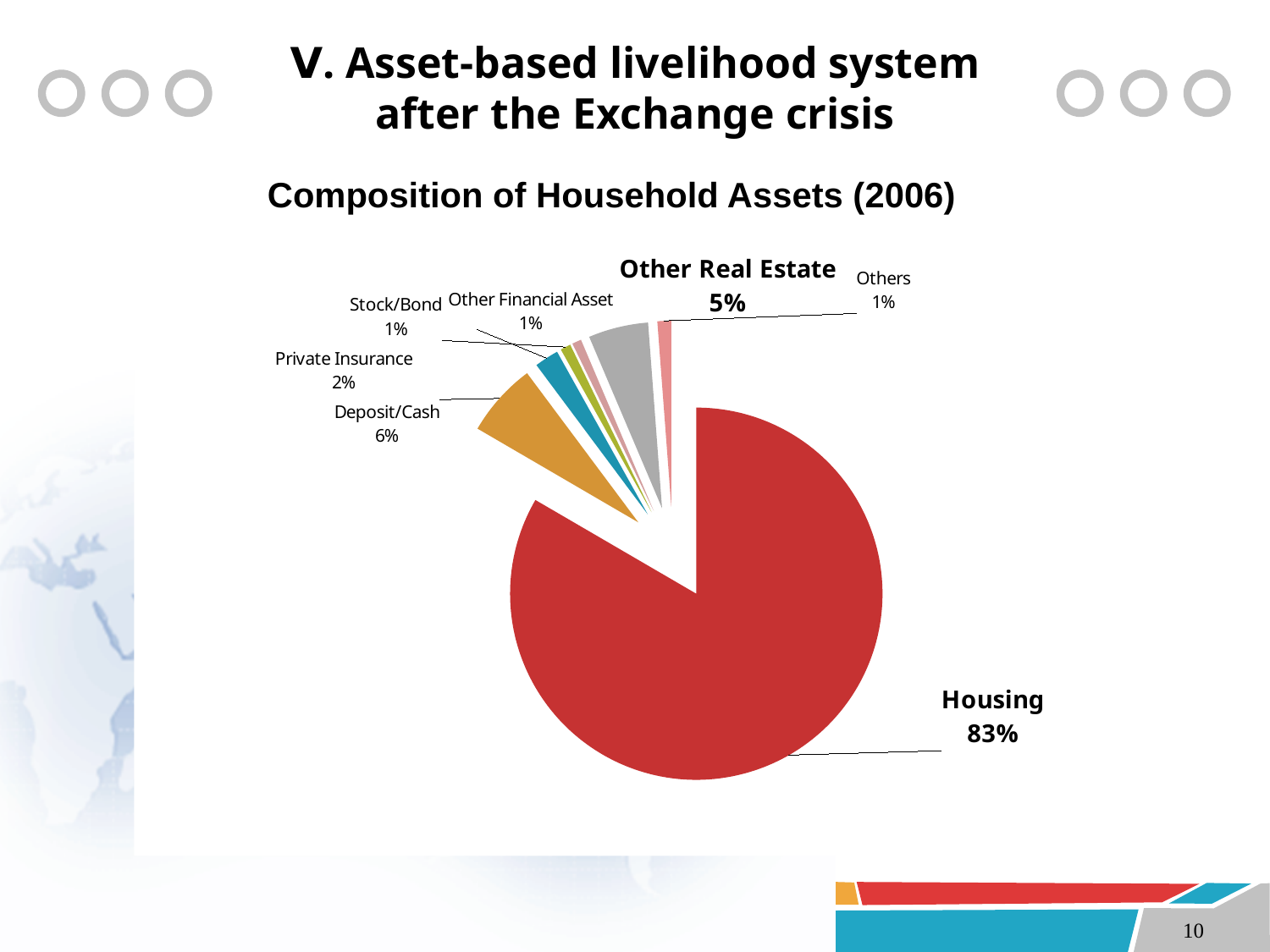
What share of household assets is Private Insurance? 2% What share of household assets is Other Real Estate? 5% What kind of chart is shown on the slide? Pie chart How many categories are shown in the pie chart? 7 Which category has the largest share of household assets? Housing What share of household assets is Stock/Bond? 1% What colour is the Housing slice? Red What share of household assets is Deposit/Cash? 6% Which is larger, the share for Deposit/Cash or the share for Other Real Estate? Deposit/Cash What is the title of the chart? Composition of Household Assets (2006) What is the difference between the Housing share and the Deposit/Cash share? 77% What share of household assets is Housing? 83%